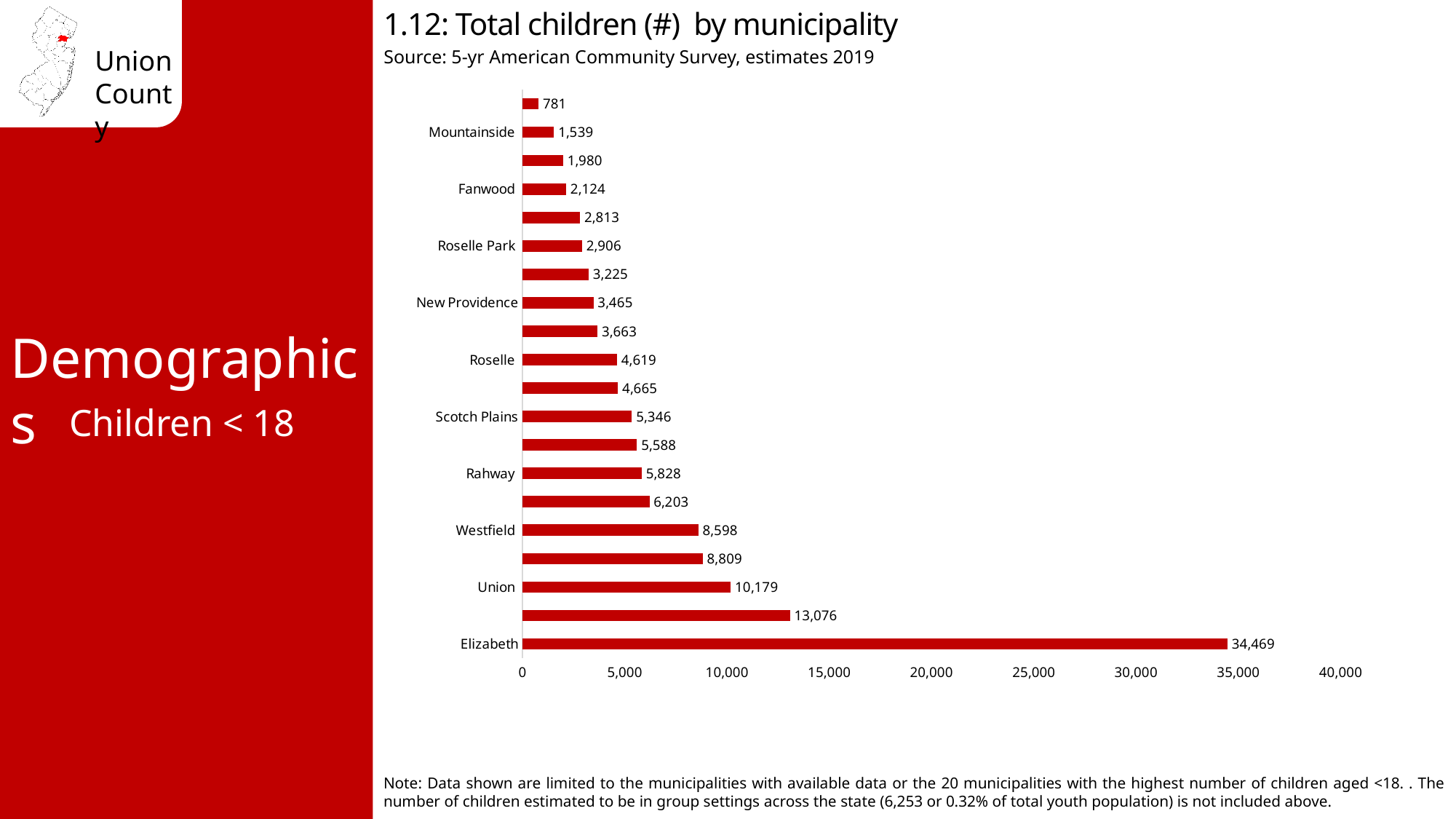
What is the value shown on the shortest bar in the chart? 781 What is the total number of children for Westfield? 8,598 What is the total number of children for Mountainside? 1,539 Which has more children, Westfield or Rahway? Westfield What is the difference between the values for Elizabeth and Union? 24,290 What is the total number of children for Scotch Plains? 5,346 What is the total number of children for Elizabeth? 34,469 Is the value for Roselle greater or less than 5,000? less What is the title of the chart? 1.12: Total children (#) by municipality What type of chart is shown on the slide? Bar chart Which municipality has the highest number of children? Elizabeth How many bars are plotted in the chart? 20